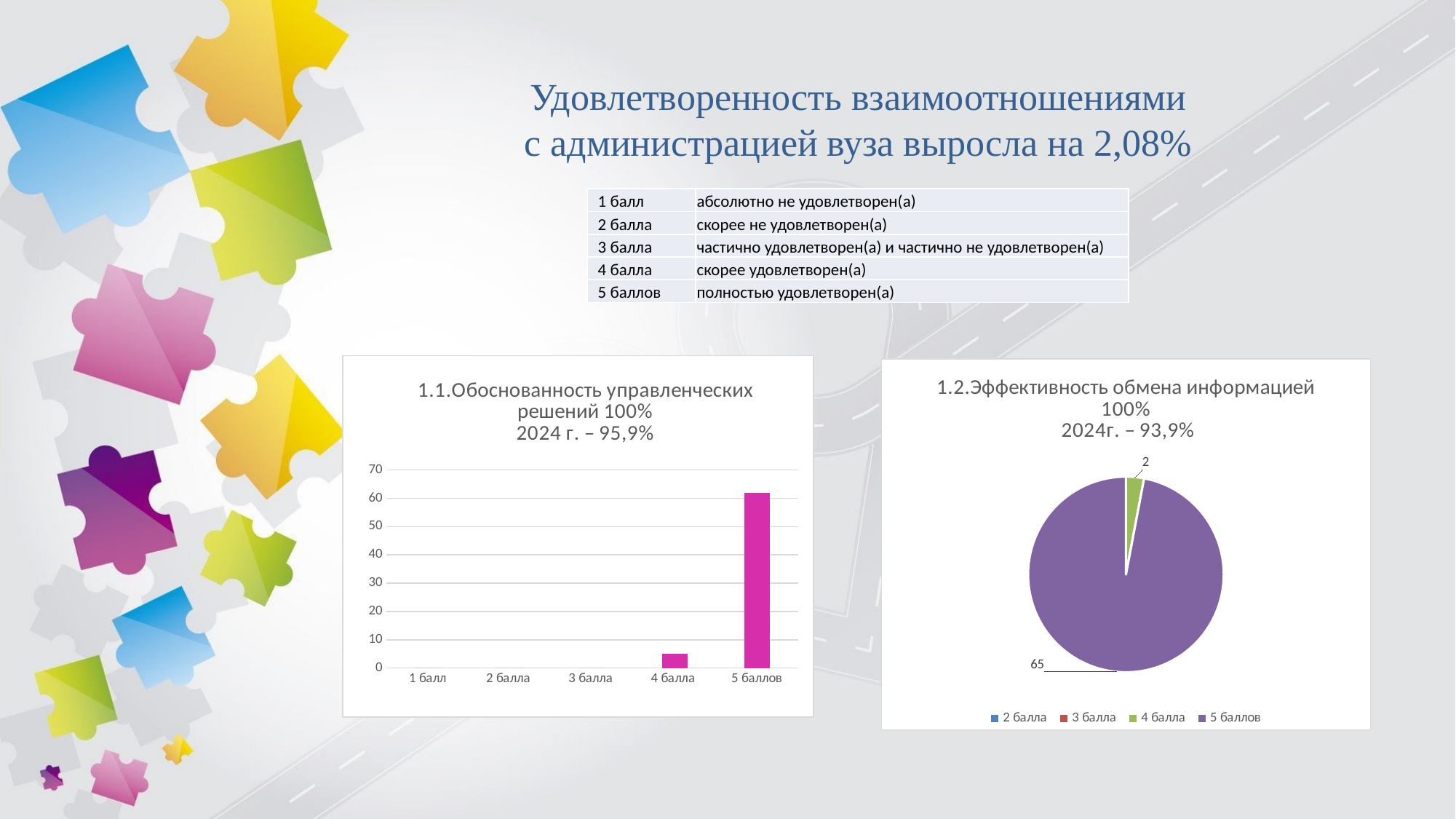
In the right pie chart '1.2.Эффективность обмена информацией', which slice is the largest? 5 баллов In the left chart '1.1.Обоснованность управленческих решений', which category has the highest bar? 5 баллов In the left chart '1.1.Обоснованность управленческих решений', how many categories are shown on the x axis? 5 In the right pie chart '1.2.Эффективность обмена информацией', how many entries does the legend list? 4 In the right pie chart '1.2.Эффективность обмена информацией', what is the value labelled for the 5 баллов slice? 65 In the left chart '1.1.Обоснованность управленческих решений', which is larger: the bar for 4 балла or the bar for 5 баллов? 5 баллов What kind of chart is the right chart, '1.2.Эффективность обмена информацией'? pie chart In the right pie chart '1.2.Эффективность обмена информацией', what is the value labelled for the 4 балла slice? 2 What kind of chart is the left chart, '1.1.Обоснованность управленческих решений'? bar chart In the left chart '1.1.Обоснованность управленческих решений', is the value for 4 балла greater or less than 10? less In the left chart '1.1.Обоснованность управленческих решений', is the value for 5 баллов greater or less than 50? greater In the right pie chart '1.2.Эффективность обмена информацией', what is the difference between the 5 баллов slice and the 4 балла slice? 63